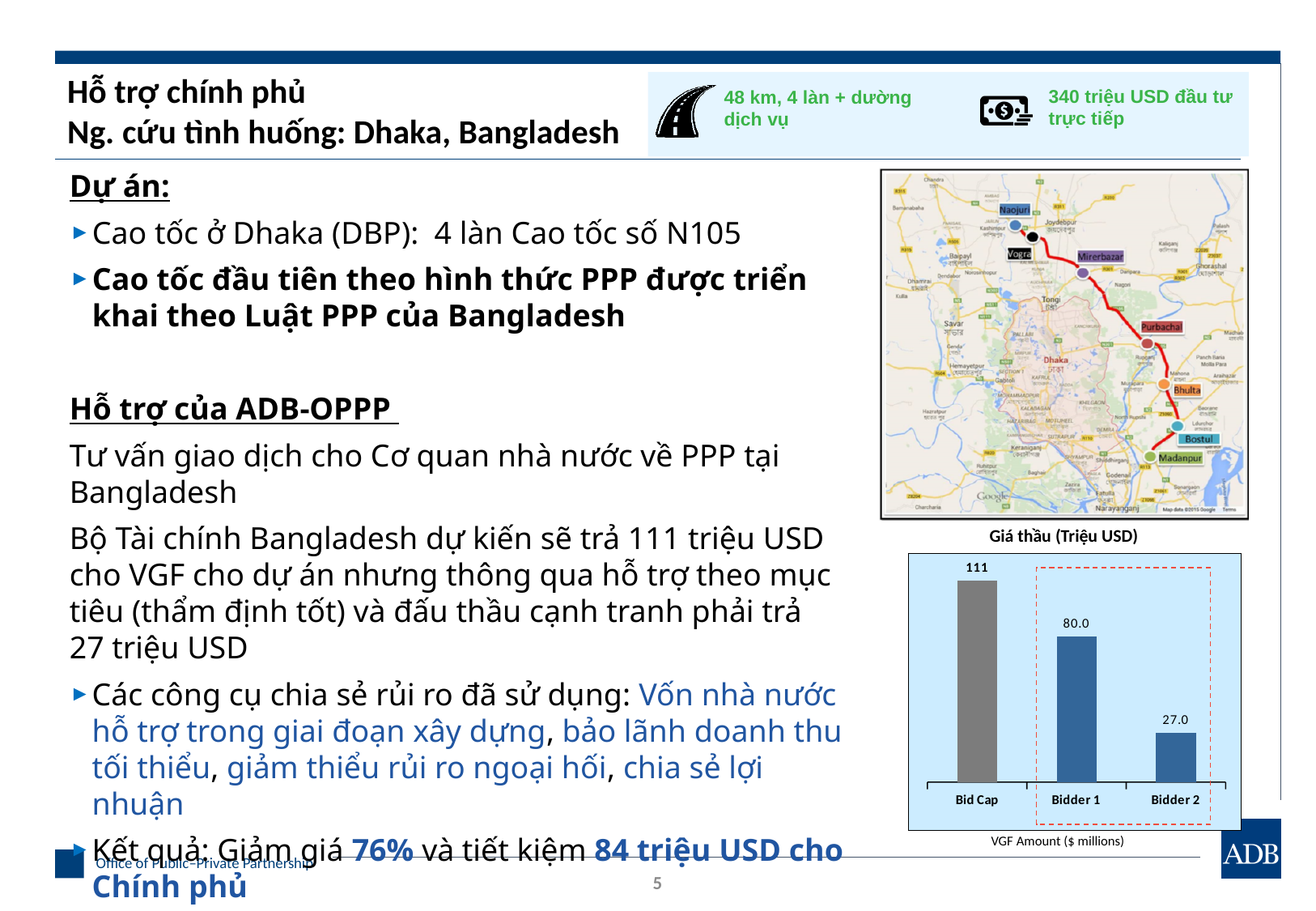
What is the value for Bid Cap in the chart? 111 What is the difference between the Bid Cap value and the Bidder 2 value? 84 Which category has the highest value in the chart? Bid Cap What kind of chart is shown on the slide? Bar chart Do the values rise or fall from left to right across the chart? Fall What is the value for Bidder 2 in the chart? 27.0 Which is larger, the value for Bidder 1 or the value for Bidder 2? Bidder 1 Which category has the lowest value in the chart? Bidder 2 What is the value for Bidder 1 in the chart? 80.0 How many categories are shown in the chart? 3 What is the difference between the values for Bidder 1 and Bidder 2? 53.0 What is the title of the chart? Giá thầu (Triệu USD)